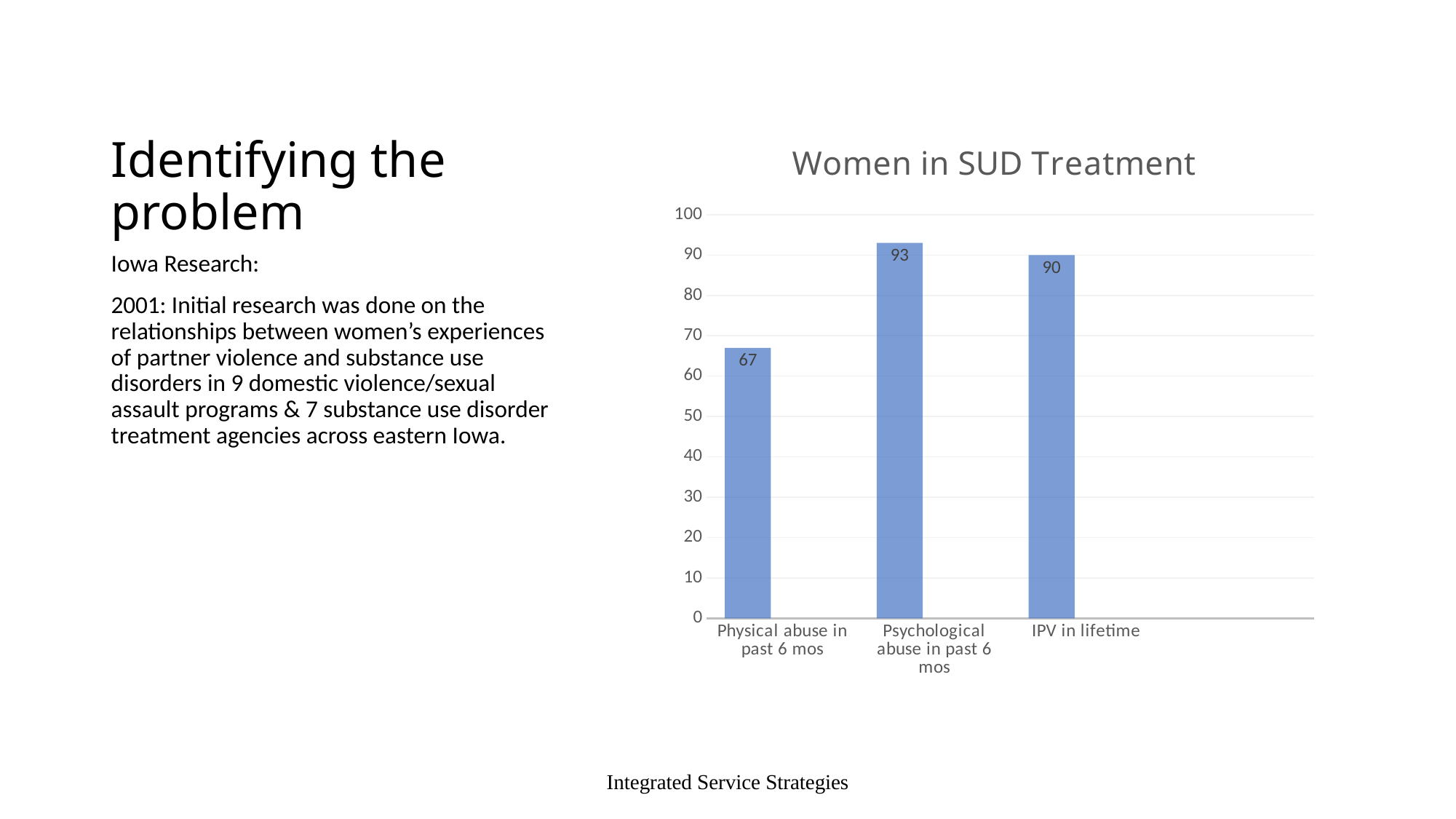
Which category has the highest value? Psychological abuse in past 6 mos Which is larger, the value for IPV in lifetime or the value for Physical abuse in past 6 mos? IPV in lifetime Is the value for Physical abuse in past 6 mos greater or less than 70? less What is the value for Psychological abuse in past 6 mos? 93 What is the value for IPV in lifetime? 90 What is the difference between the values for IPV in lifetime and Physical abuse in past 6 mos? 23 What is the value for Physical abuse in past 6 mos? 67 What is the difference between the values for Psychological abuse in past 6 mos and Physical abuse in past 6 mos? 26 Which category has the lowest value? Physical abuse in past 6 mos How many categories are shown in the chart? 3 What is the title of the chart? Women in SUD Treatment What kind of chart is shown on the slide? bar chart